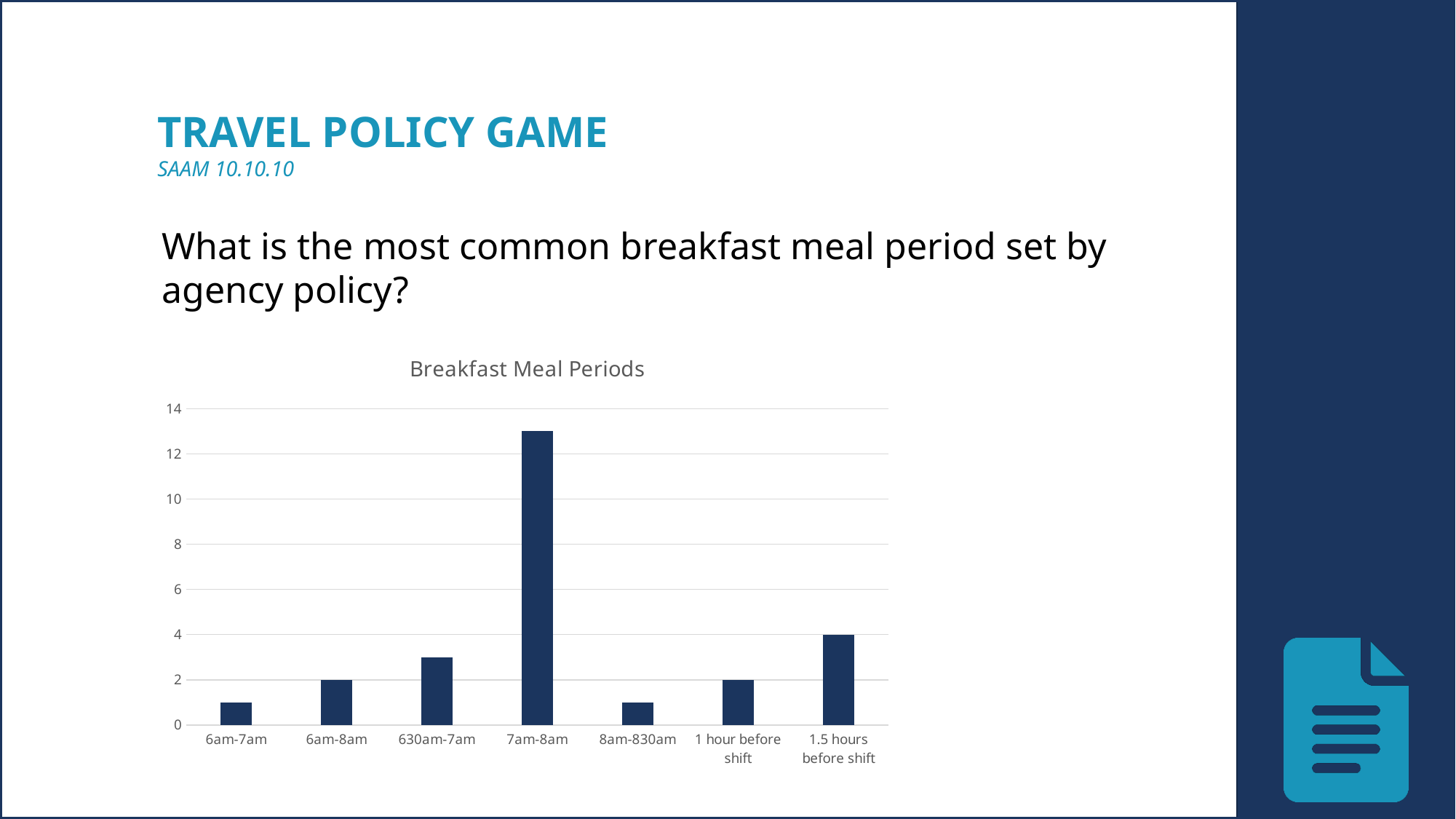
What is the value for 1.5 hours before shift? 4 Is the value for 630am-7am greater or less than 4? less Is the value for 7am-8am greater or less than 12? greater What is the title of the chart? Breakfast Meal Periods Is the value for 8am-830am greater or less than 2? less Which is larger, the value for 7am-8am or the value for 1.5 hours before shift? 7am-8am What is the difference between the value for 1.5 hours before shift and the value for 6am-8am? 2 What type of chart is shown on the slide? bar chart What is the value for 1 hour before shift? 2 How many breakfast meal period categories are shown on the x axis? 7 What is the value for 6am-8am? 2 Which breakfast meal period has the highest bar? 7am-8am